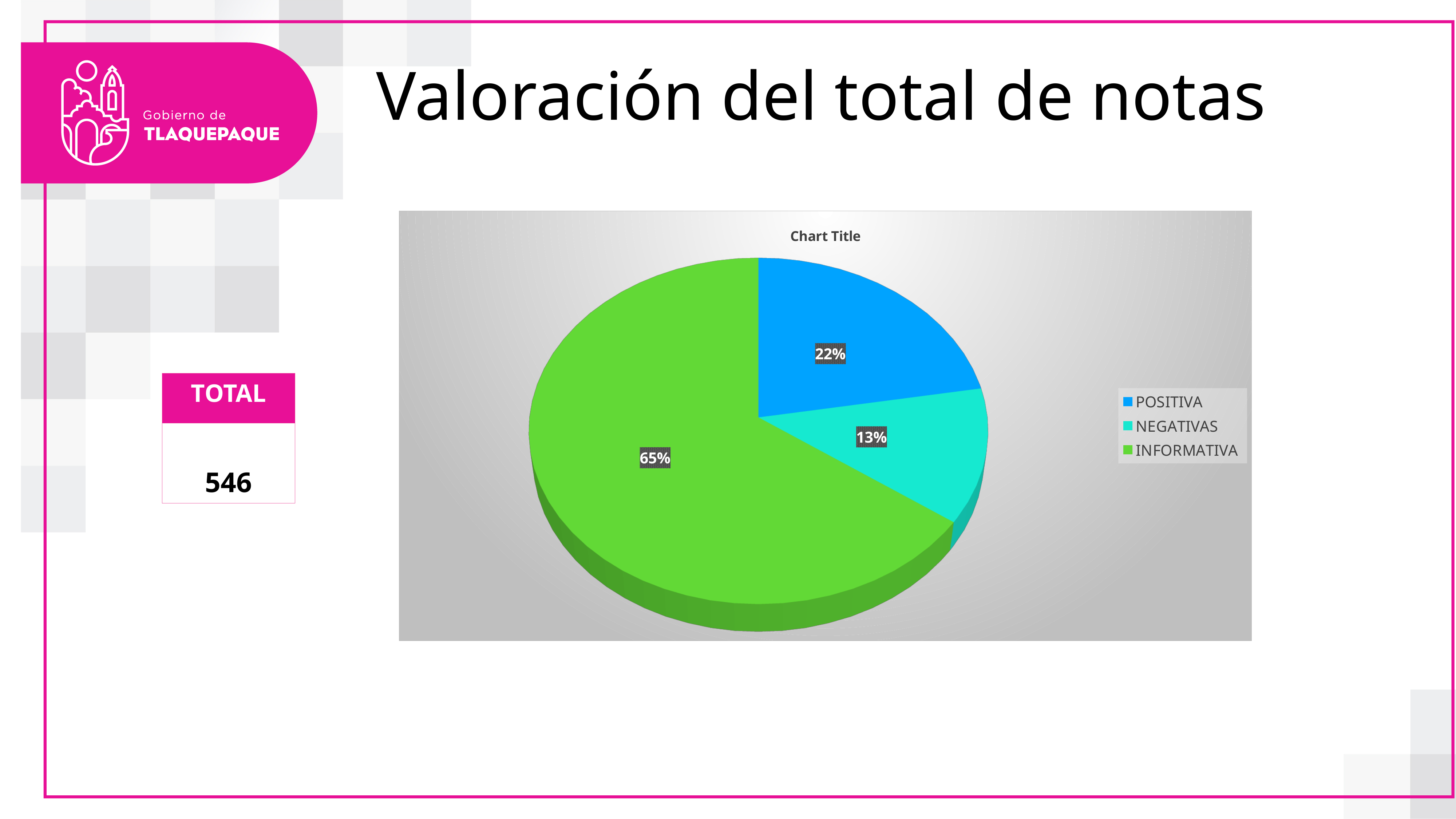
What percentage of the pie does the INFORMATIVA slice represent? 65% Which category has the smallest slice of the pie? NEGATIVAS What title is printed above the pie chart? Chart Title Which category has the largest slice of the pie? INFORMATIVA Which slice is larger, POSITIVA or NEGATIVAS? POSITIVA What colour is the INFORMATIVA slice in the pie chart? green What percentage of the pie does the NEGATIVAS slice represent? 13% How many slices does the pie chart have? 3 What percentage of the pie does the POSITIVA slice represent? 22% What kind of chart is shown on the slide? pie chart How many entries does the legend list? 3 What is the difference in percentage points between the INFORMATIVA and POSITIVA slices? 43